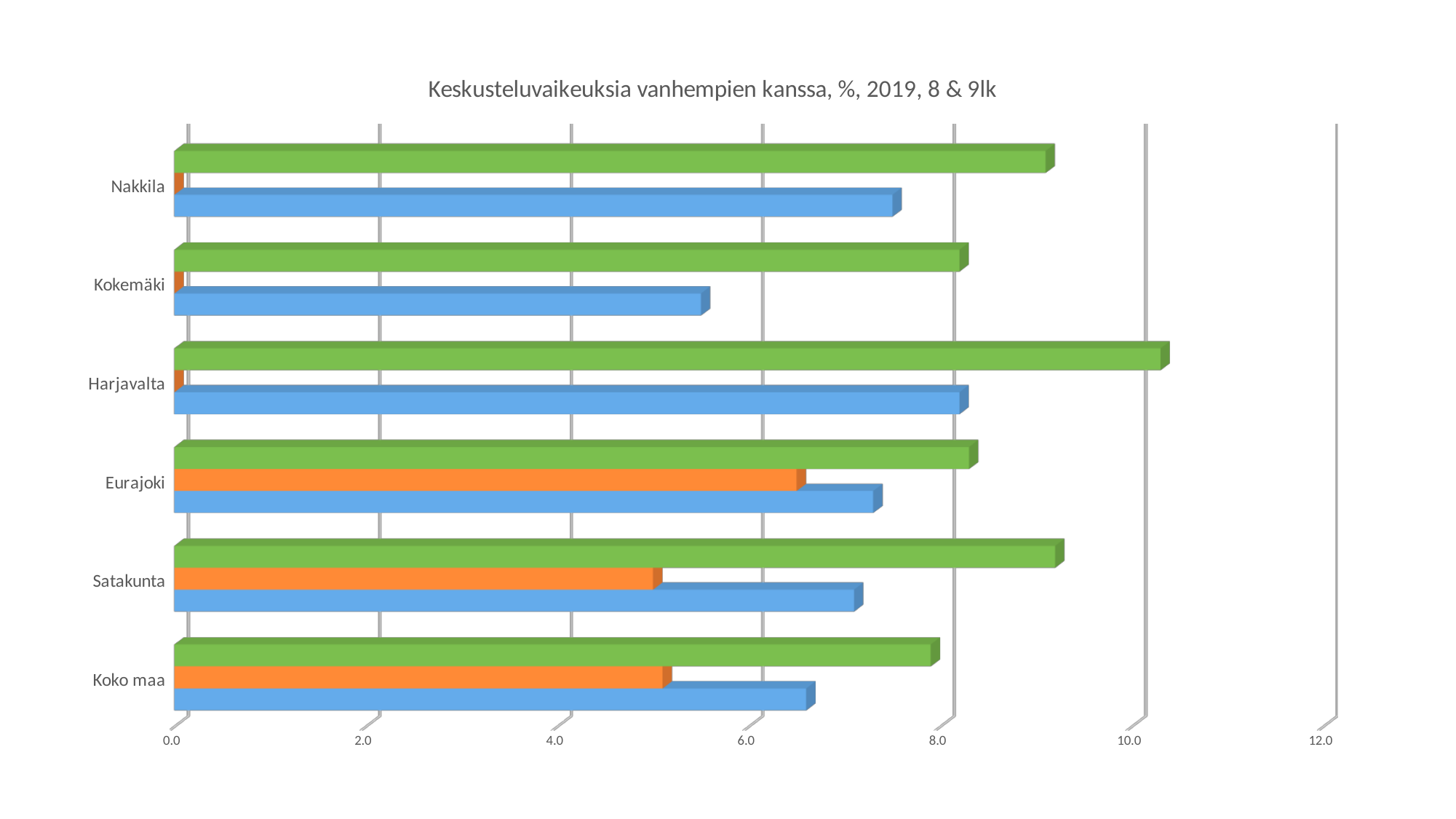
Is the value of the green bar for Harjavalta greater or less than 10.0? greater What kind of chart is shown on the slide? bar chart Which category has the shortest blue bar? Kokemäki Which is larger, the orange bar for Eurajoki or the orange bar for Koko maa? Eurajoki Which is larger, the green bar for Nakkila or the green bar for Kokemäki? Nakkila How many categories are shown on the vertical axis of the chart? 6 What is the title of the chart? Keskusteluvaikeuksia vanhempien kanssa, %, 2019, 8 & 9lk Is the value of the blue bar for Kokemäki greater or less than 6.0? less Which category has the longest blue bar? Harjavalta Is the value of the blue bar for Nakkila greater or less than 8.0? less Which category has the longest green bar? Harjavalta